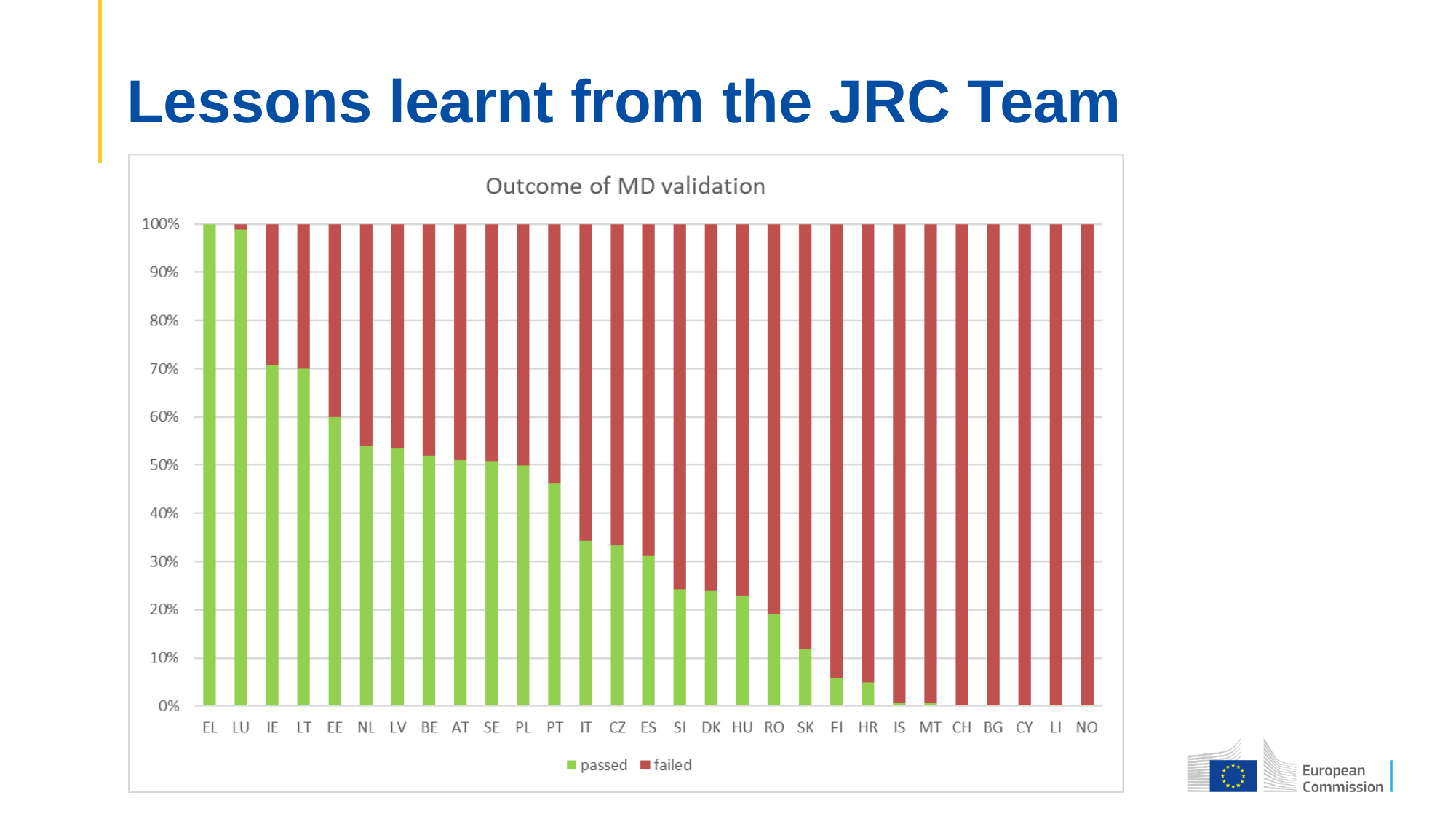
Is the passed share for SK greater or less than 10%? greater What is the passed share for EL? 100% What is the title of the chart? Outcome of MD validation Which has a larger passed share, IT or SI? IT What kind of chart is shown on the slide? Stacked bar chart How many countries are shown on the x axis of the chart? 29 How many series does the legend list? 2 Does the passed share rise or fall moving from left to right along the x axis? fall Is the passed share for PT greater or less than 50%? less Is the passed share for FI greater or less than 10%? less Which country has the highest share of passed validations? EL